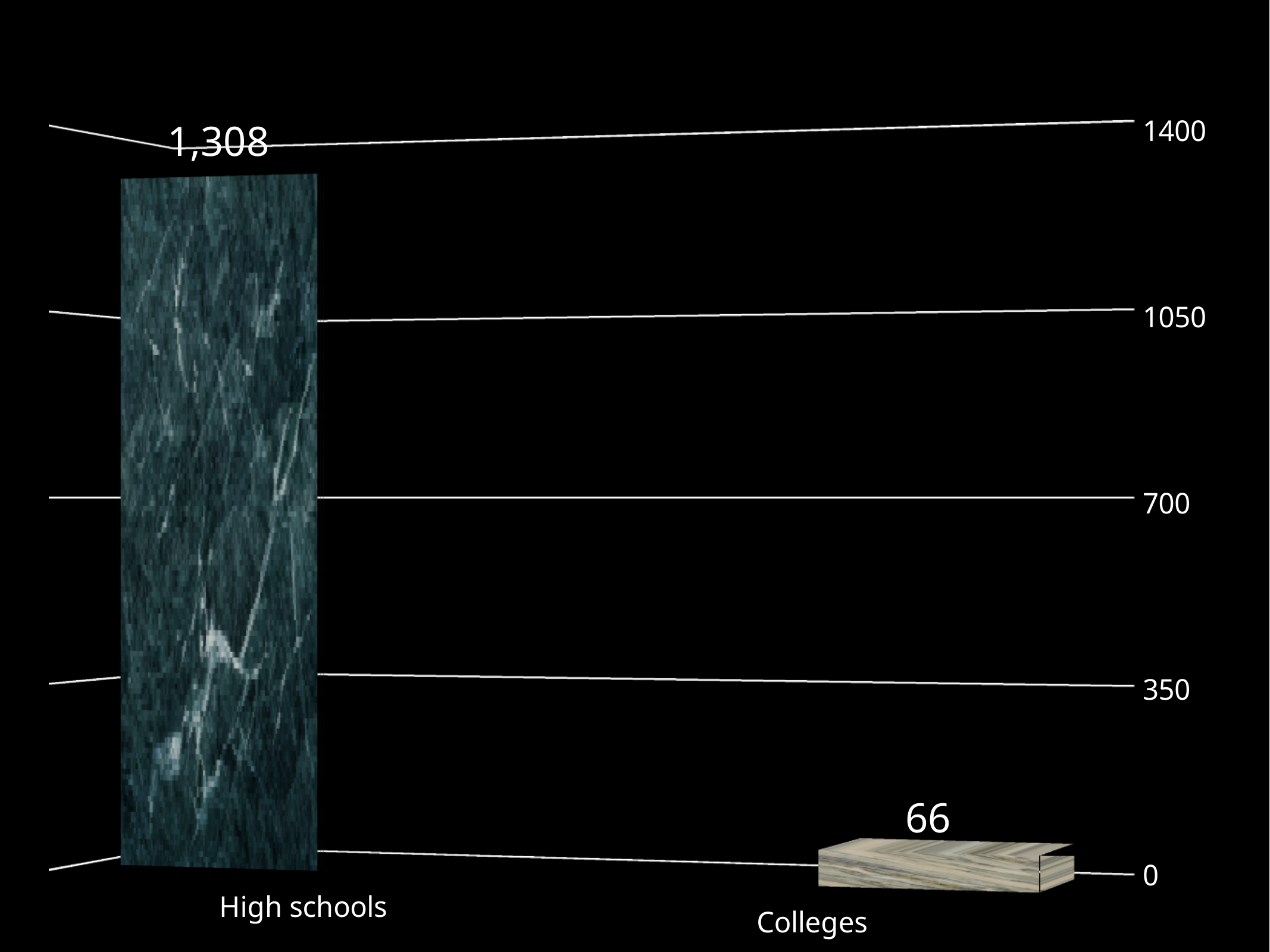
Is the value for High schools greater or less than 1050? greater What is the total of the values for High schools and Colleges? 1,374 What is the highest value shown on the vertical axis? 1400 Which category has the highest value? High schools What is the value for Colleges? 66 How many categories are shown in the chart? 2 Is the value for Colleges greater or less than 350? less Which category has the lowest value? Colleges What kind of chart is shown on the slide? bar chart What is the difference between the values for High schools and Colleges? 1,242 Which is larger, the value for High schools or the value for Colleges? High schools What is the value for High schools? 1,308